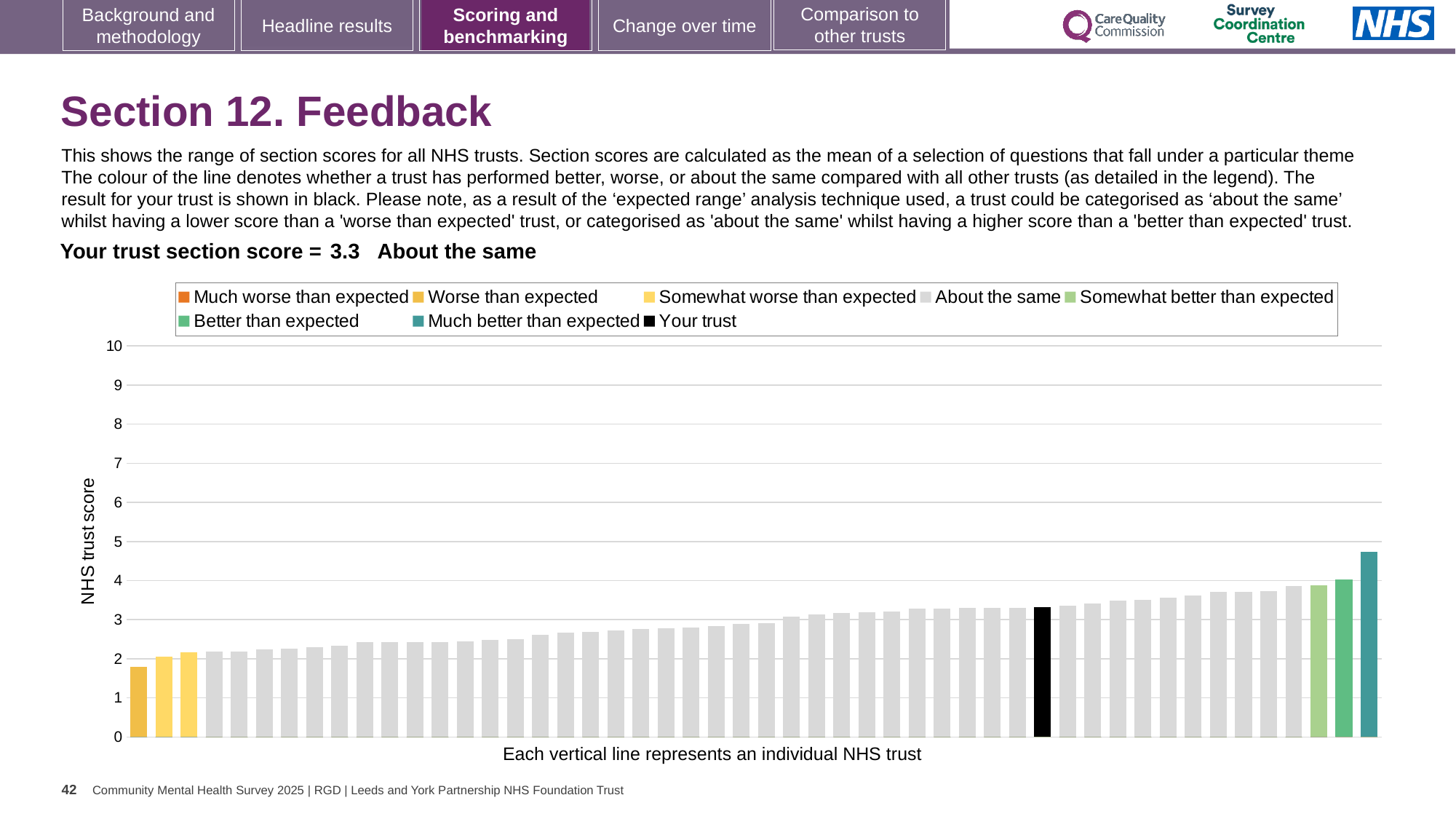
Which category is your trust placed in for Section 12. Feedback? About the same Is your trust's score greater or less than 3? greater How many entries does the chart legend list? 8 What is your trust's section score for Section 12. Feedback? 3.3 Is the value of the lowest bar greater or less than 2? less Which legend category does the highest bar belong to? Much better than expected Which legend category does the lowest bar belong to? Worse than expected Is the value of the highest bar greater or less than 4? greater What kind of chart is shown on the slide? Bar chart What colour is used for the bar representing your trust? Black Do the bar values rise or fall from left to right along the x axis? Rise Which is larger, your trust's score or the score of the highest-scoring trust? The highest-scoring trust